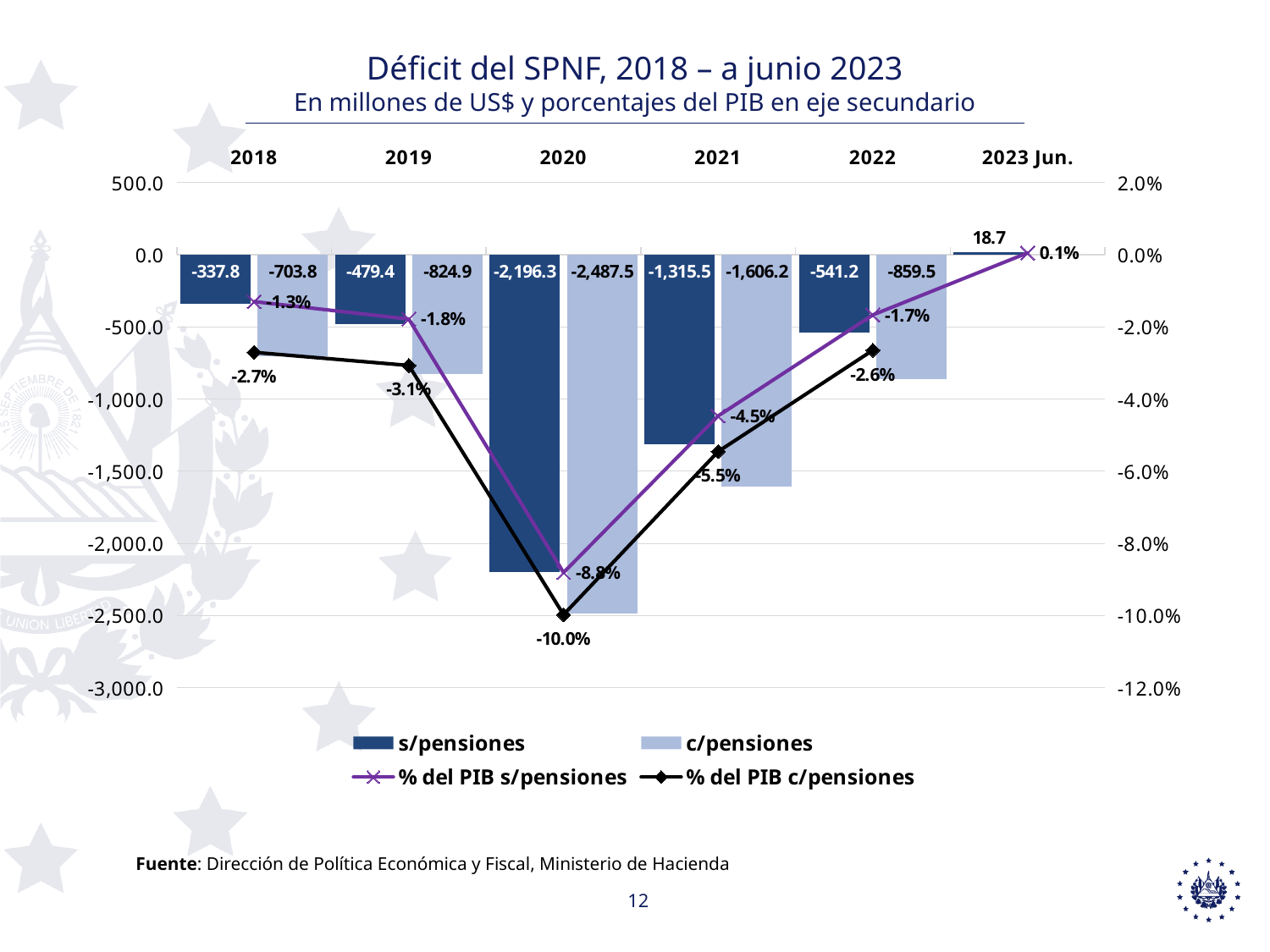
What is the s/pensiones value for 2023 Jun.? 18.7 What is the % del PIB c/pensiones value for 2020? -10.0% How many series does the legend list? 4 What is the % del PIB s/pensiones value for 2021? -4.5% Does the % del PIB s/pensiones line rise or fall from 2020 to 2023 Jun.? Rise Which is larger, the s/pensiones value for 2019 or for 2022? 2019 (-479.4) What is the difference between the c/pensiones and s/pensiones values for 2018? 366.0 How many time periods are shown on the x axis? 6 What is the value of the c/pensiones bar for 2021? -1,606.2 What is the value of the s/pensiones bar for 2020? -2,196.3 In which year is the c/pensiones bar lowest? 2020 What kind of chart is this? Combination bar and line chart